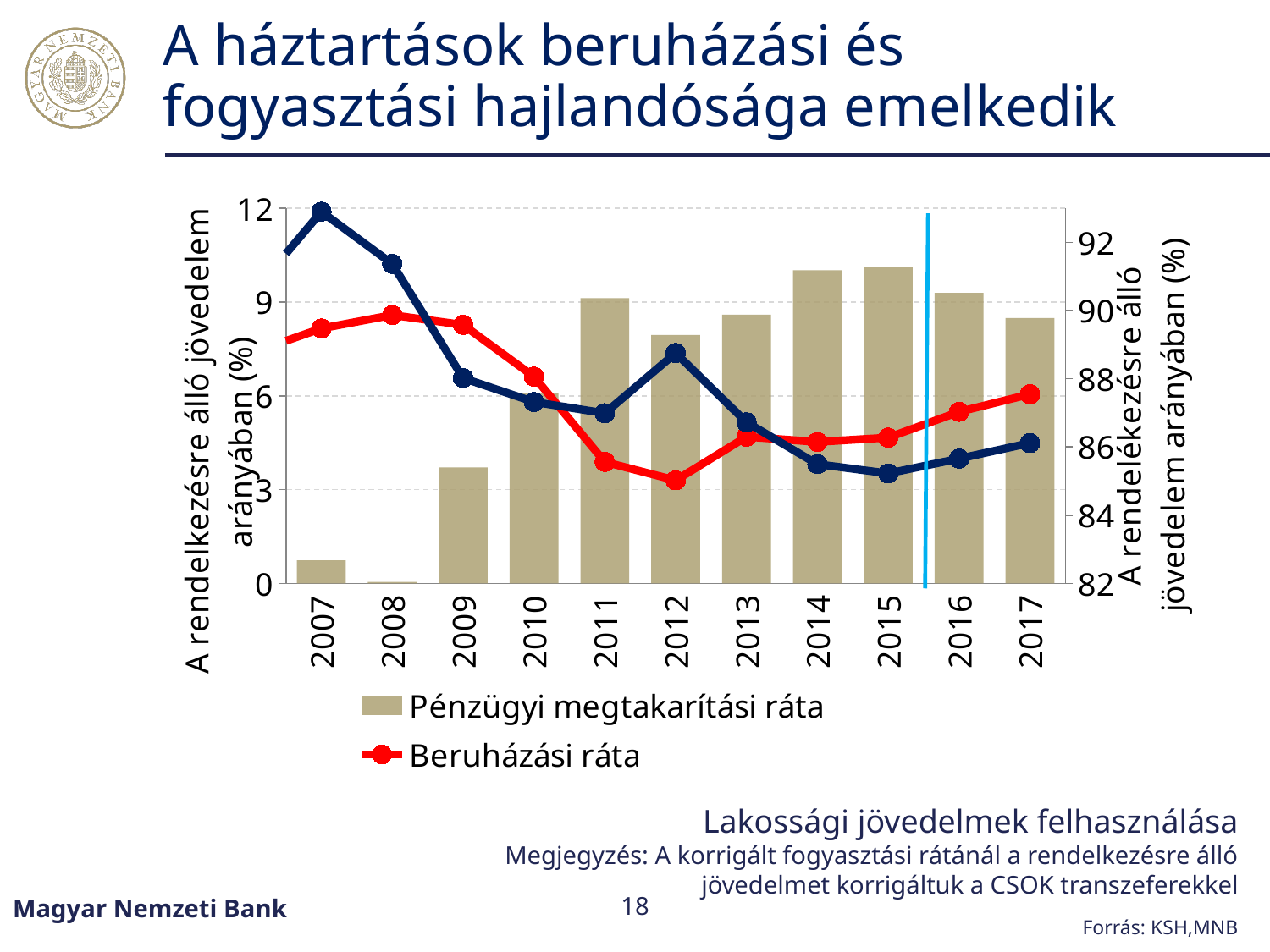
Is the Pénzügyi megtakarítási ráta for 2009 greater or less than 6? less Is the Beruházási ráta for 2012 greater or less than 6? less Which is larger, the Pénzügyi megtakarítási ráta bar for 2010 or for 2011? 2011 Does the Beruházási ráta rise or fall from 2012 to 2017? rise What kind of chart is shown on the slide? A combined bar and line chart How many years are shown on the x axis of the chart? 11 In which year is the Beruházási ráta at its lowest? 2012 Which year has the lowest Pénzügyi megtakarítási ráta bar? 2008 Which is larger, the Beruházási ráta in 2007 or in 2011? 2007 Is the Pénzügyi megtakarítási ráta for 2014 greater or less than 9? greater What is the title given below the chart? Lakossági jövedelmek felhasználása How many series does the visible legend list? 2